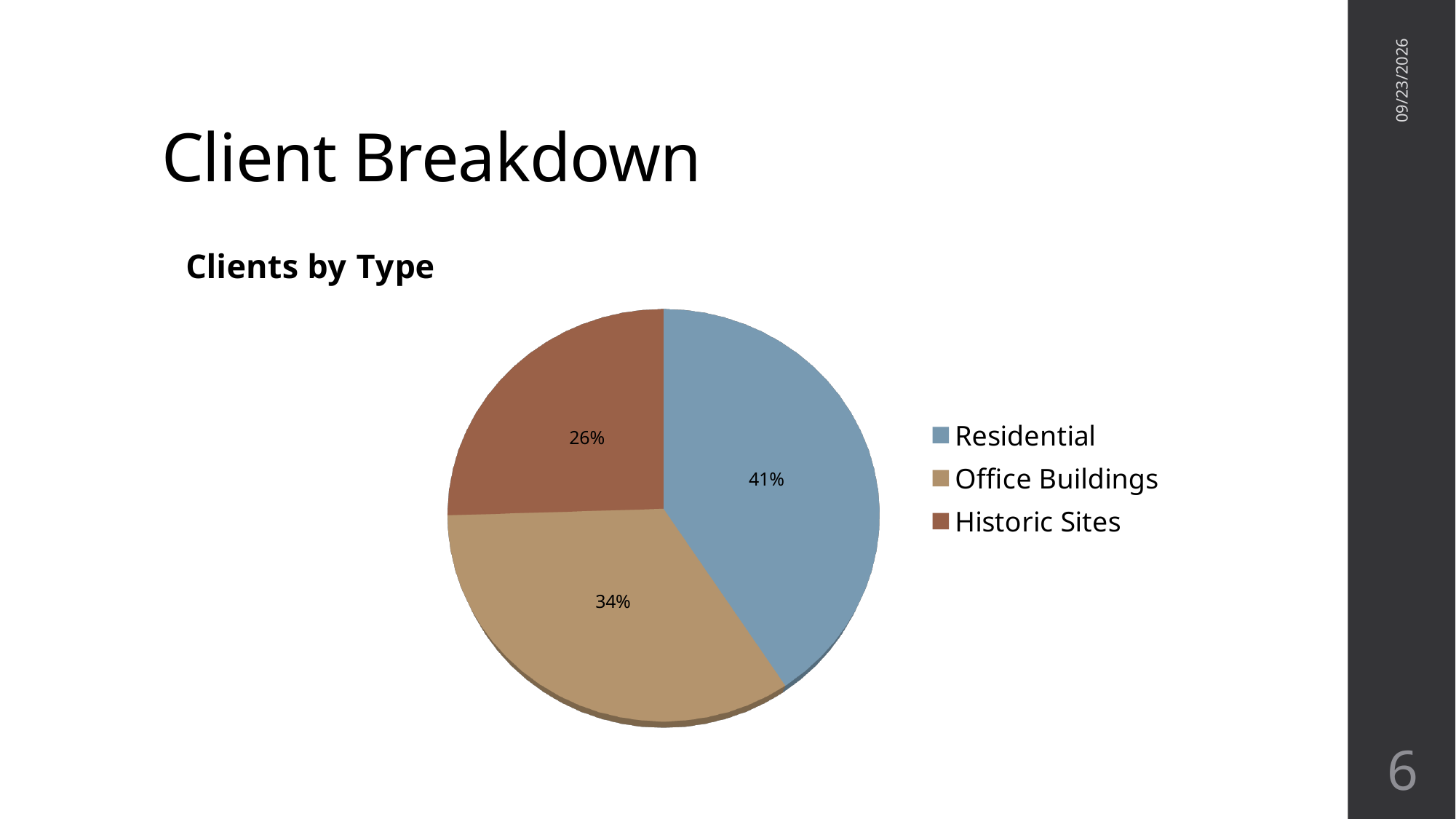
What is the difference in percentage points between the Residential and Office Buildings shares? 7 What share of clients are Residential? 41% Which client type has the smallest share of the pie? Historic Sites What share of clients are Office Buildings? 34% What is the difference in percentage points between the Residential and Historic Sites shares? 15 Which is larger, the Office Buildings share or the Historic Sites share? Office Buildings What is the title of the chart? Clients by Type How many client types are shown in the pie chart? 3 Which client type has the largest share of the pie? Residential What share of clients are Historic Sites? 26% What kind of chart is shown on the slide? Pie chart Which colour represents Historic Sites in the legend? Brown